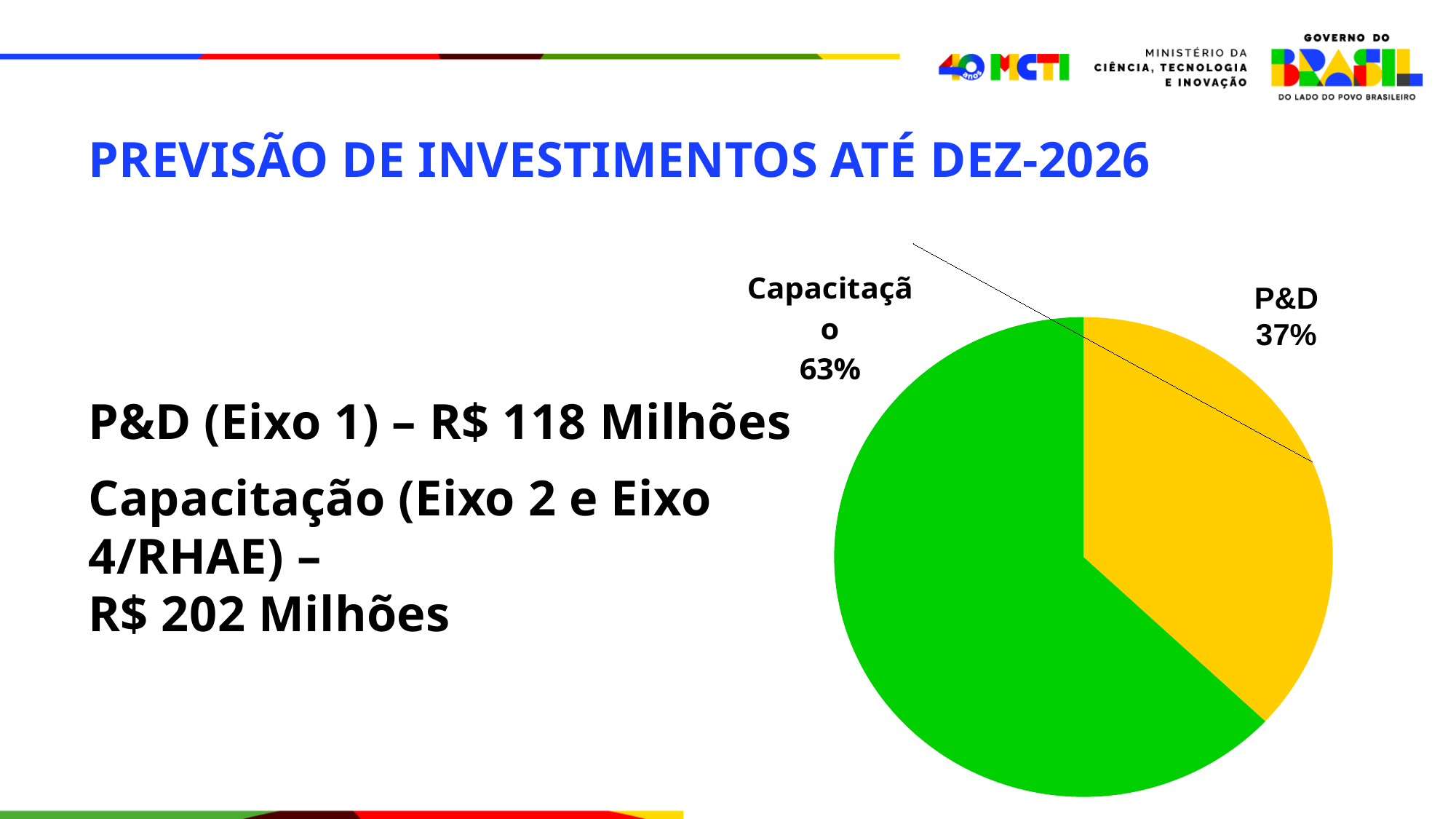
Which slice of the pie is the largest? Capacitação What colour is the Capacitação slice of the pie? green What is the difference in percentage points between the Capacitação slice and the P&D slice? 26 Is the share for P&D greater or less than 50%? less What colour is the P&D slice of the pie? yellow What share of the pie does P&D represent? 37% Which slice of the pie is the smallest? P&D Which is larger, the P&D slice or the Capacitação slice? Capacitação How many slices does the pie chart have? 2 What share of the pie does Capacitação represent? 63% What kind of chart is shown on the slide? pie chart